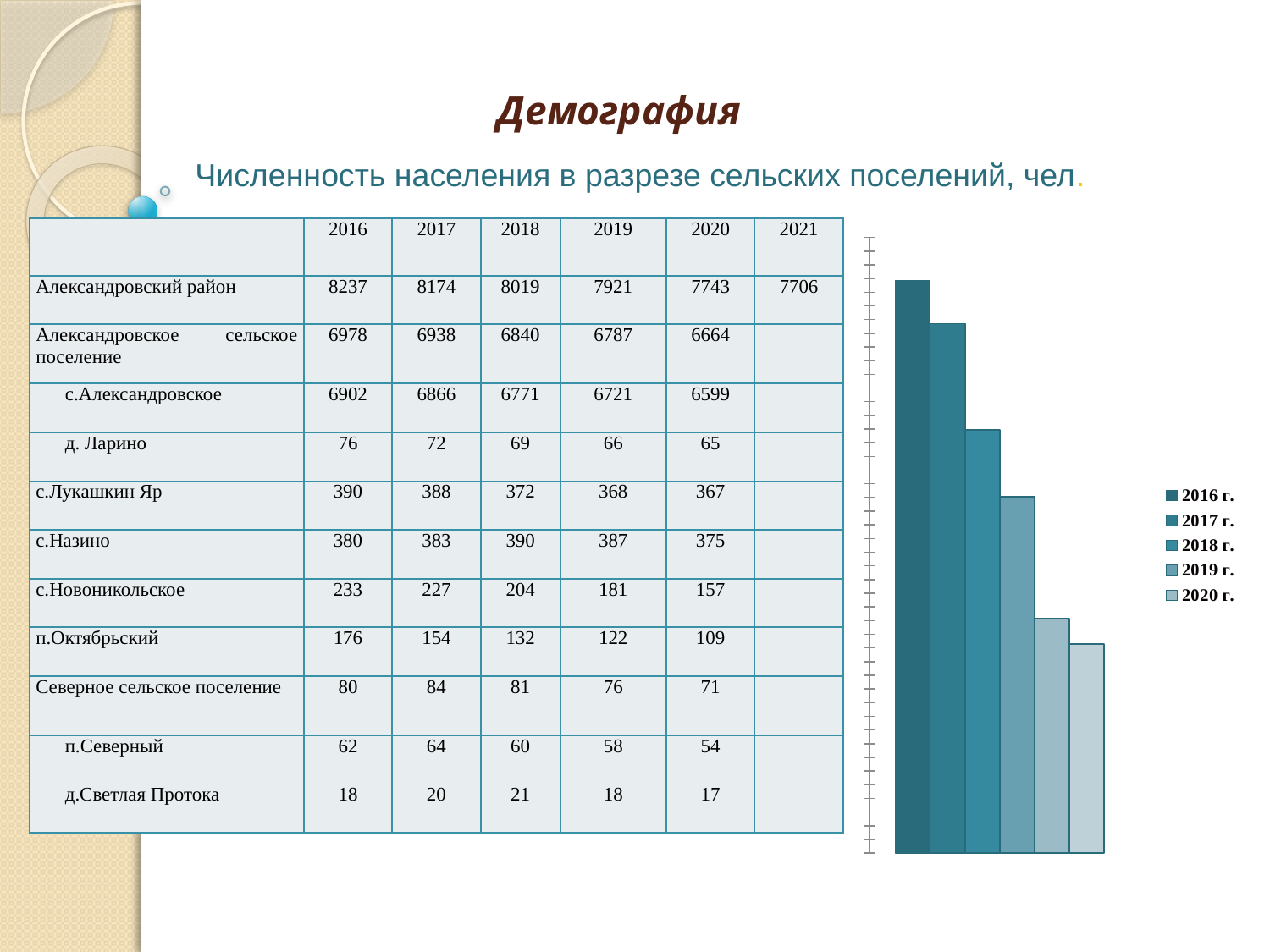
Which bar in the chart is the shortest, the leftmost or the rightmost? rightmost Is the leftmost bar in the chart taller or shorter than the second bar from the left? taller What is the first entry listed in the chart's legend? 2016 г. How many bars are plotted in the chart? 6 Do the bar heights rise or fall from left to right across the chart? fall What kind of chart is shown on the right side of the slide? bar chart How many series does the legend of the chart list? 5 What is the last entry listed in the chart's legend? 2020 г. Which bar in the chart is the tallest, the leftmost or the rightmost? leftmost